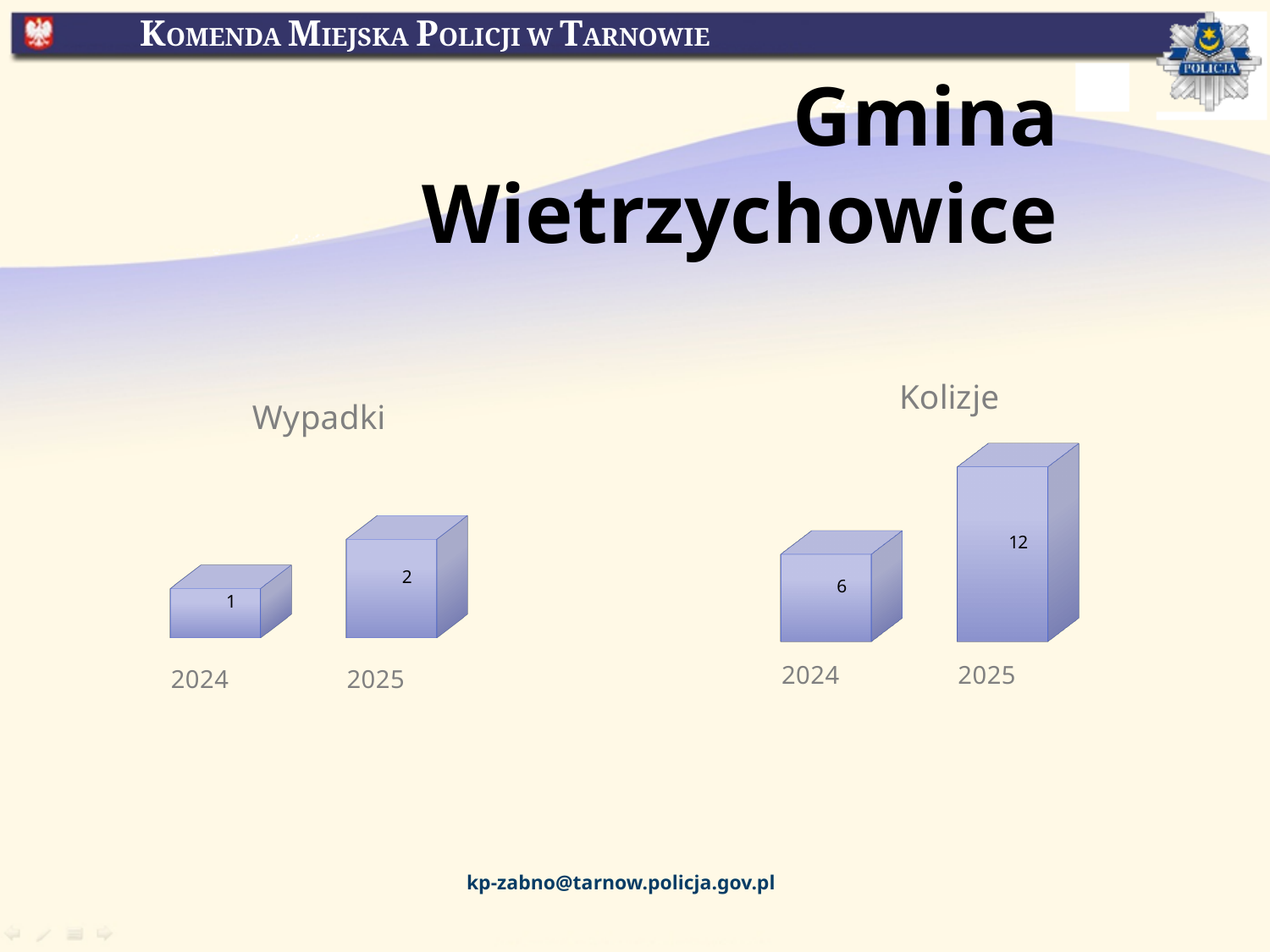
How many categories does the Wypadki chart show? 2 In the Kolizje chart, what is the value for 2025? 12 In the Kolizje chart, which is larger: the value for 2024 or the value for 2025? 2025 In the Kolizje chart, do the values rise or fall from 2024 to 2025? rise What kind of chart is the Kolizje chart? bar chart In the Wypadki chart, what is the value for 2024? 1 In the Kolizje chart, which year has the highest value? 2025 In the Kolizje chart, what is the difference between the 2025 and 2024 values? 6 In the Wypadki chart, what is the value for 2025? 2 In the Kolizje chart, what is the value for 2024? 6 In the Wypadki chart, which year has the lowest value? 2024 In the Wypadki chart, what is the difference between the 2025 and 2024 values? 1